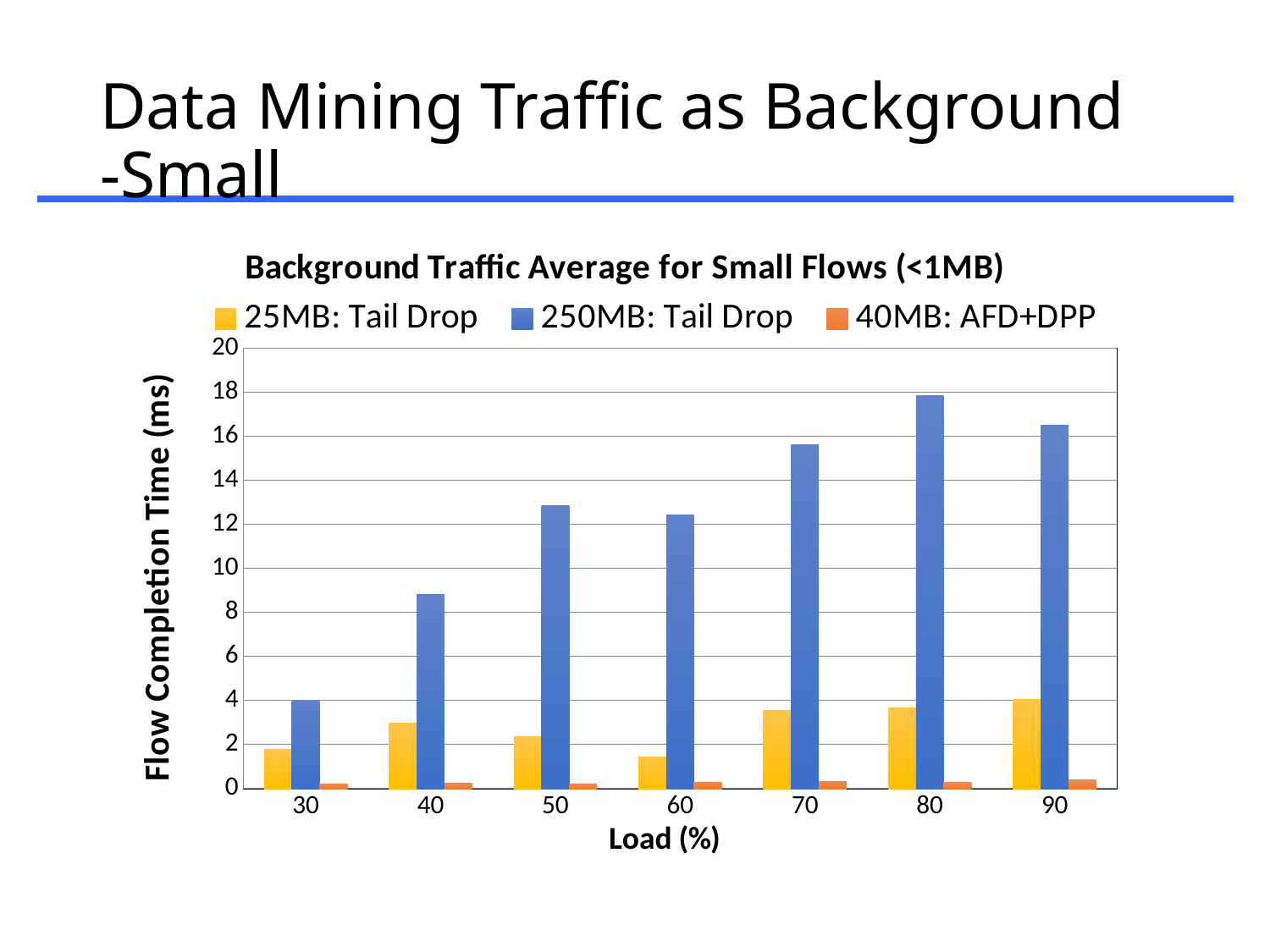
Is the 250MB: Tail Drop value at 40% load greater or less than 10? less What kind of chart is shown on the slide? bar chart What is the title of the chart? Background Traffic Average for Small Flows (<1MB) Is the 25MB: Tail Drop value at 90% load greater or less than 2? greater Is the 250MB: Tail Drop value at 80% load greater or less than 16? greater How many series does the legend list? 3 Which is larger for 250MB: Tail Drop, the value at 80% load or at 90% load? 80% load Which is larger for 25MB: Tail Drop, the value at 40% load or at 60% load? 40% load At which load is the 250MB: Tail Drop value lowest? 30 At which load is the 250MB: Tail Drop value highest? 80 How many load levels are shown on the x axis? 7